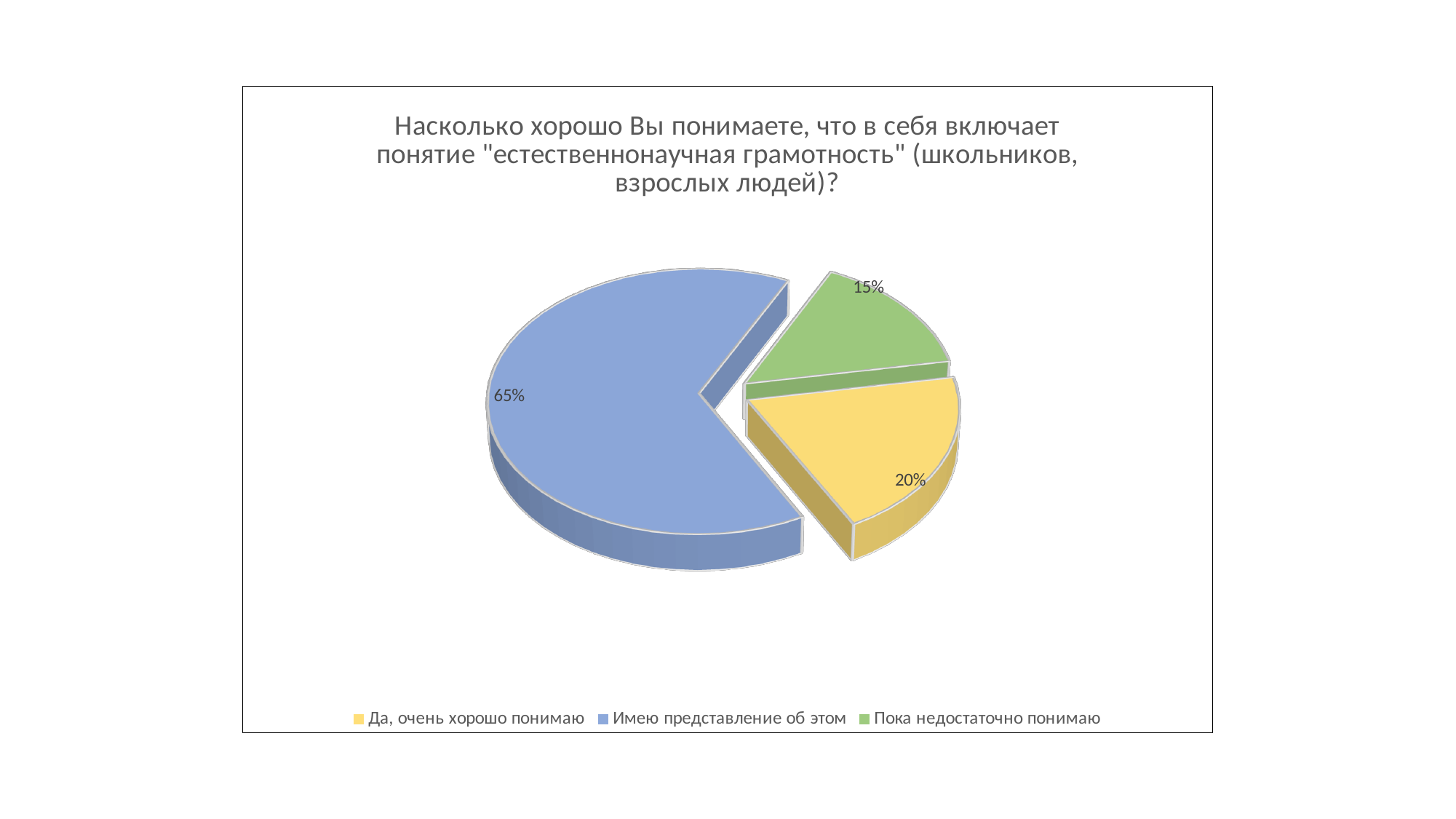
How many categories does the pie chart show? 3 What is the difference in percentage points between "Имею представление об этом" and "Да, очень хорошо понимаю"? 45 What share of the pie does "Пока недостаточно понимаю" take? 15% What share of the pie does "Имею представление об этом" take? 65% Which category has the smallest slice of the pie? Пока недостаточно понимаю What is the difference in percentage points between "Да, очень хорошо понимаю" and "Пока недостаточно понимаю"? 5 Which legend entry is shown in green? Пока недостаточно понимаю Which is larger: the slice for "Да, очень хорошо понимаю" or the slice for "Пока недостаточно понимаю"? Да, очень хорошо понимаю Which category has the largest slice of the pie? Имею представление об этом What kind of chart is shown on the slide? Pie chart What colour is the slice for "Имею представление об этом"? Blue What share of the pie does "Да, очень хорошо понимаю" take? 20%